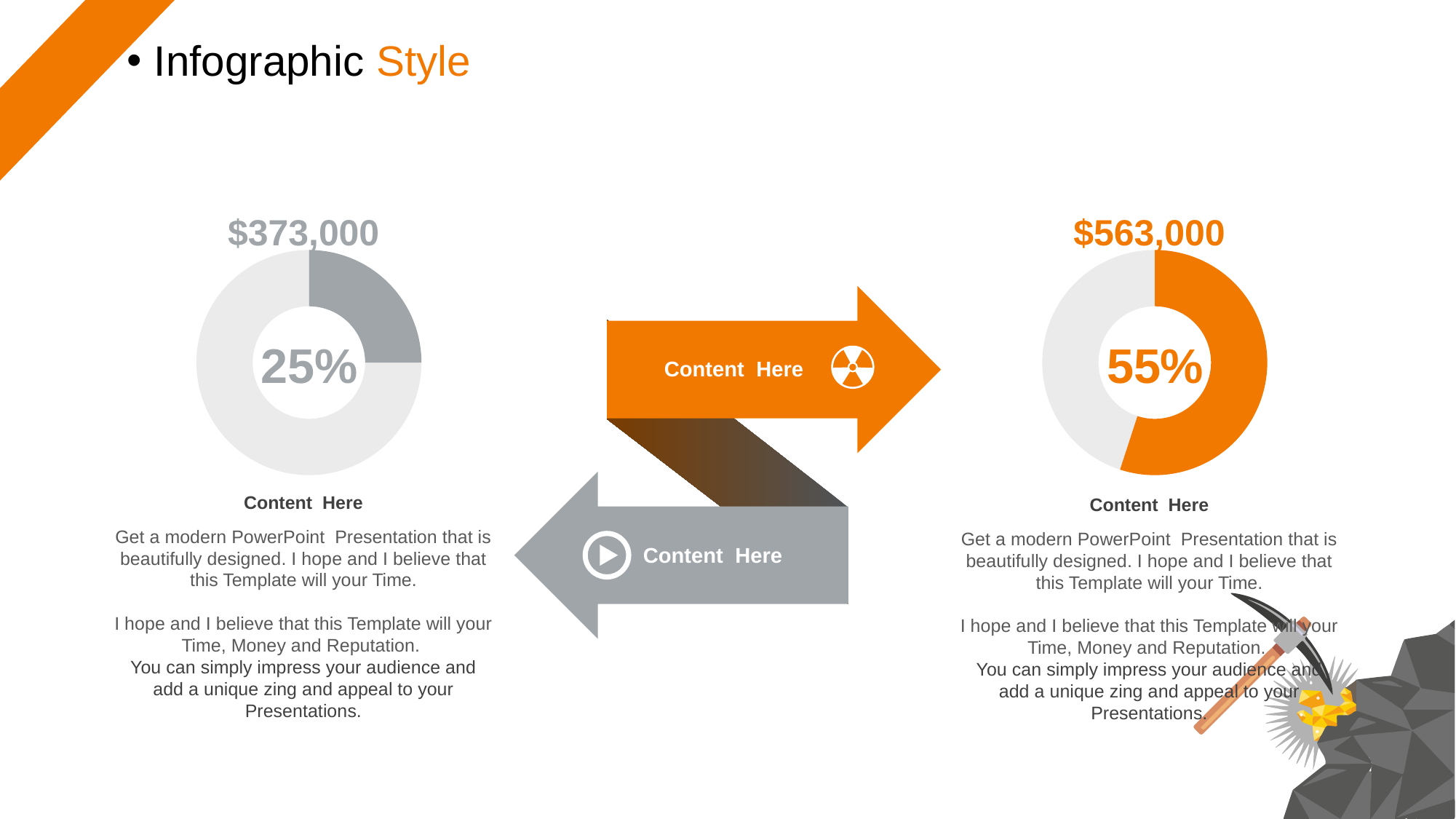
What percentage is shown in the centre of the right donut chart? 55% What is the difference between the dollar value above the right donut chart and the dollar value above the left donut chart? $190,000 What percentage is shown in the centre of the left donut chart? 25% What colour is the filled segment of the right donut chart? Orange Which donut chart shows the higher percentage, the left one or the right one? The right one What dollar value is printed above the left donut chart? $373,000 What dollar value is printed above the right donut chart? $563,000 Is the percentage shown in the left donut chart greater or less than 50%? less What kind of chart is used on the left side of the slide? Donut chart What share of the left donut chart is filled by the darker grey segment? 25% How many donut charts are on the slide? 2 What is the difference in percentage points between the right donut chart (55%) and the left donut chart (25%)? 30 percentage points